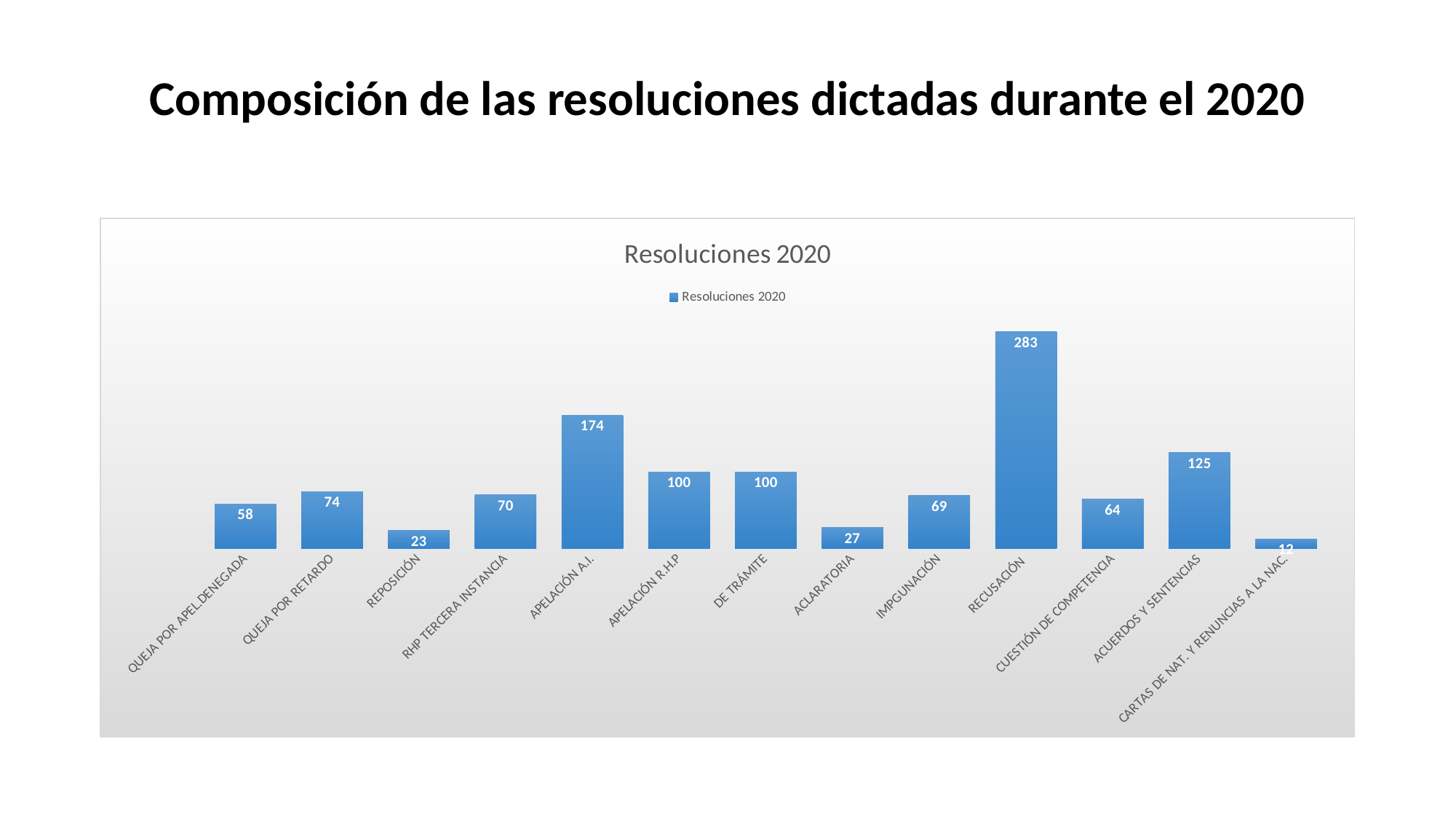
Which category has the lowest value? CARTAS DE NAT. Y RENUNCIAS A LA NAC. What is the value for APELACIÓN A.I.? 174 What is the value for ACUERDOS Y SENTENCIAS? 125 How many series does the legend list? 1 What is the difference between the values for RECUSACIÓN and APELACIÓN A.I.? 109 What is the value for REPOSICIÓN? 23 Which is larger, the value for QUEJA POR RETARDO or the value for QUEJA POR APEL.DENEGADA? QUEJA POR RETARDO What is the title of the chart? Resoluciones 2020 How many categories are shown in the chart? 13 Which category has the highest value? RECUSACIÓN What is the value for RECUSACIÓN? 283 What type of chart is shown on the slide? Bar chart